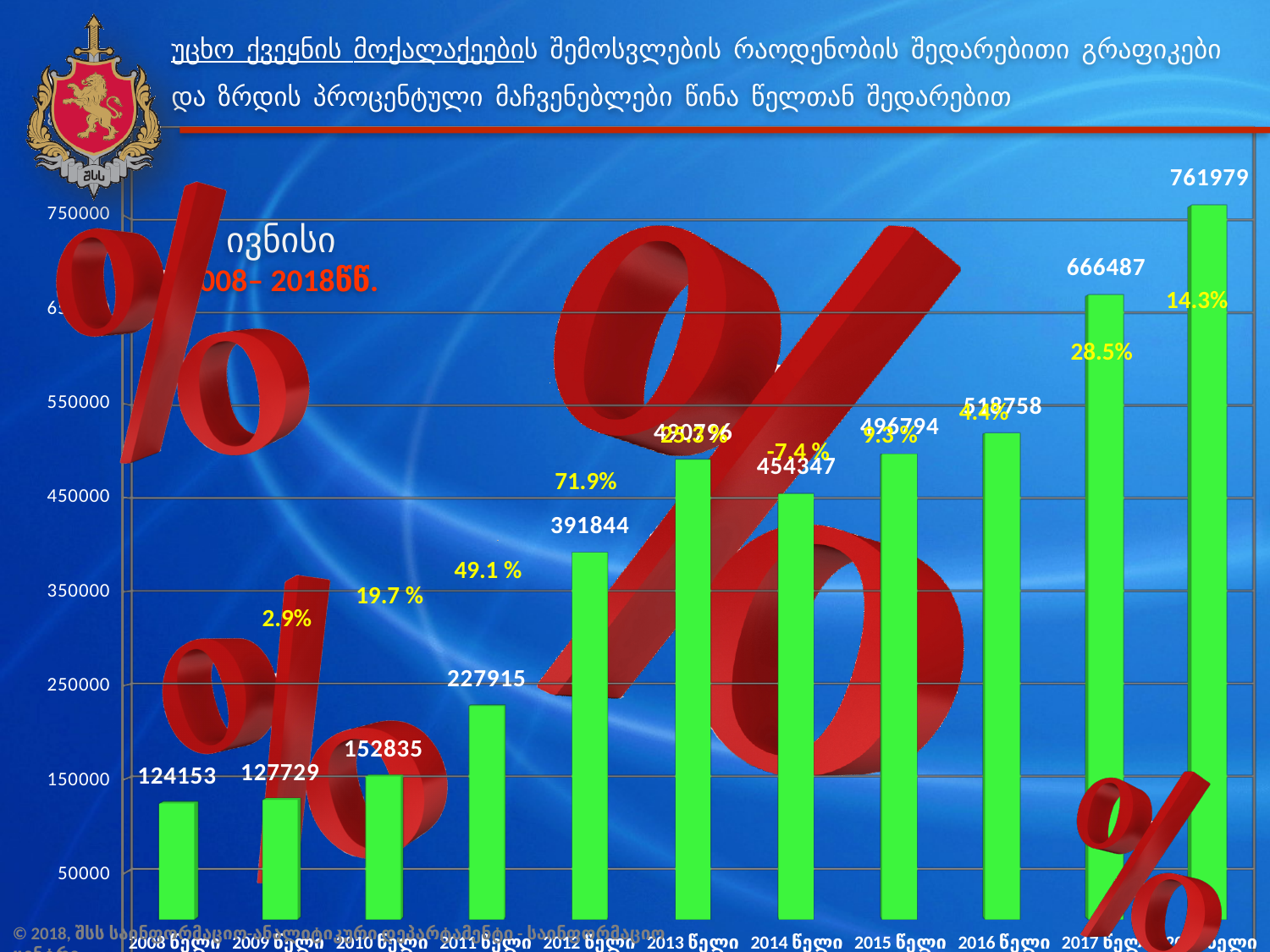
What is the value for 2011 (2011 წელი)? 227915 Which year has the highest bar? 2018 Which is larger, the value for 2014 or the value for 2015? 2015 What is the value for 2008 (2008 წელი)? 124153 What percentage growth is shown above the 2012 bar? 71.9% What is the difference between the values for 2017 and 2016? 147729 What is the value for 2017 (2017 წელი)? 666487 How many bars (years) are shown in the chart? 11 What is the value for 2016 (2016 წელი)? 518758 Which year has the lowest bar? 2008 Is the value for 2011 greater or less than 250000? less What kind of chart is shown on the slide? bar chart